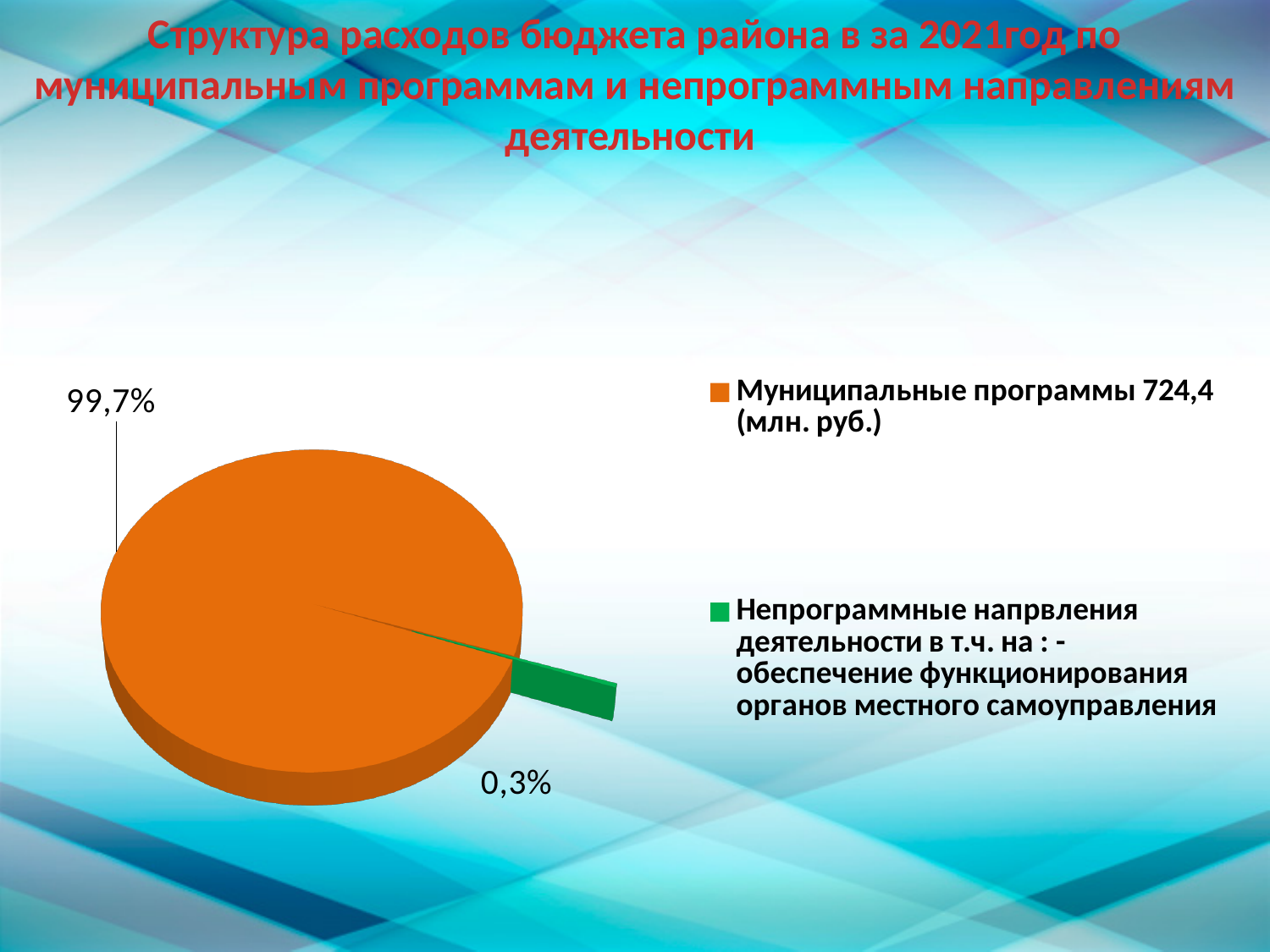
What share of the pie is labelled for Непрограммные напрвления деятельности? 0,3% Which slice is the largest in the pie chart? Муниципальные программы What is the difference in percentage points between the 99,7% slice and the 0,3% slice? 99,4 Which is larger: the share for Муниципальные программы or the share for Непрограммные напрвления деятельности? Муниципальные программы How many slices does the pie chart have? 2 What colour is the slice for Непрограммные напрвления деятельности? green What kind of chart is shown on the slide? pie chart How many entries does the legend list? 2 What colour is the slice for Муниципальные программы? orange What amount in млн. руб. is given in the legend for Муниципальные программы? 724,4 Which slice is the smallest in the pie chart? Непрограммные напрвления деятельности What share of the pie is labelled for Муниципальные программы? 99,7%